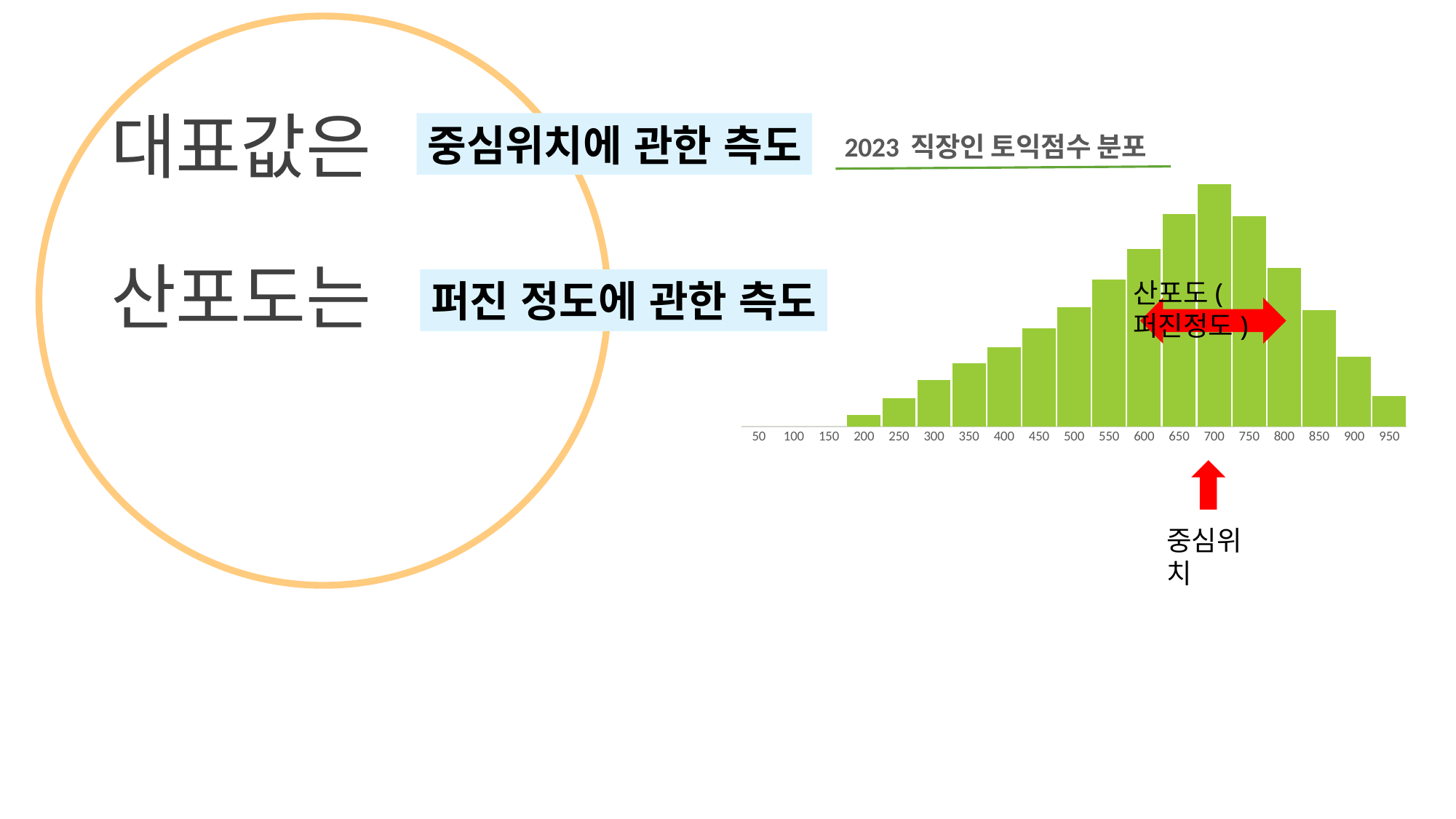
What kind of chart is shown on the slide? Bar chart Among the categories that have a visible bar, which has the shortest bar? 200 How many tick labels are shown on the x axis? 19 Which bar is taller, the one at 550 or the one at 850? 550 Which bar is taller, the one at 300 or the one at 900? 900 Do the bar heights rise or fall as the x axis goes from 200 to 700? Rise Do the bar heights rise or fall as the x axis goes from 700 to 950? Fall How many visible bars are plotted in the chart? 16 What is the title of the chart? 2023 직장인 토익점수 분포 What colour are the bars in the chart? Green Which x-axis category has the tallest bar? 700 Which bar is taller, the one at 600 or the one at 800? 600